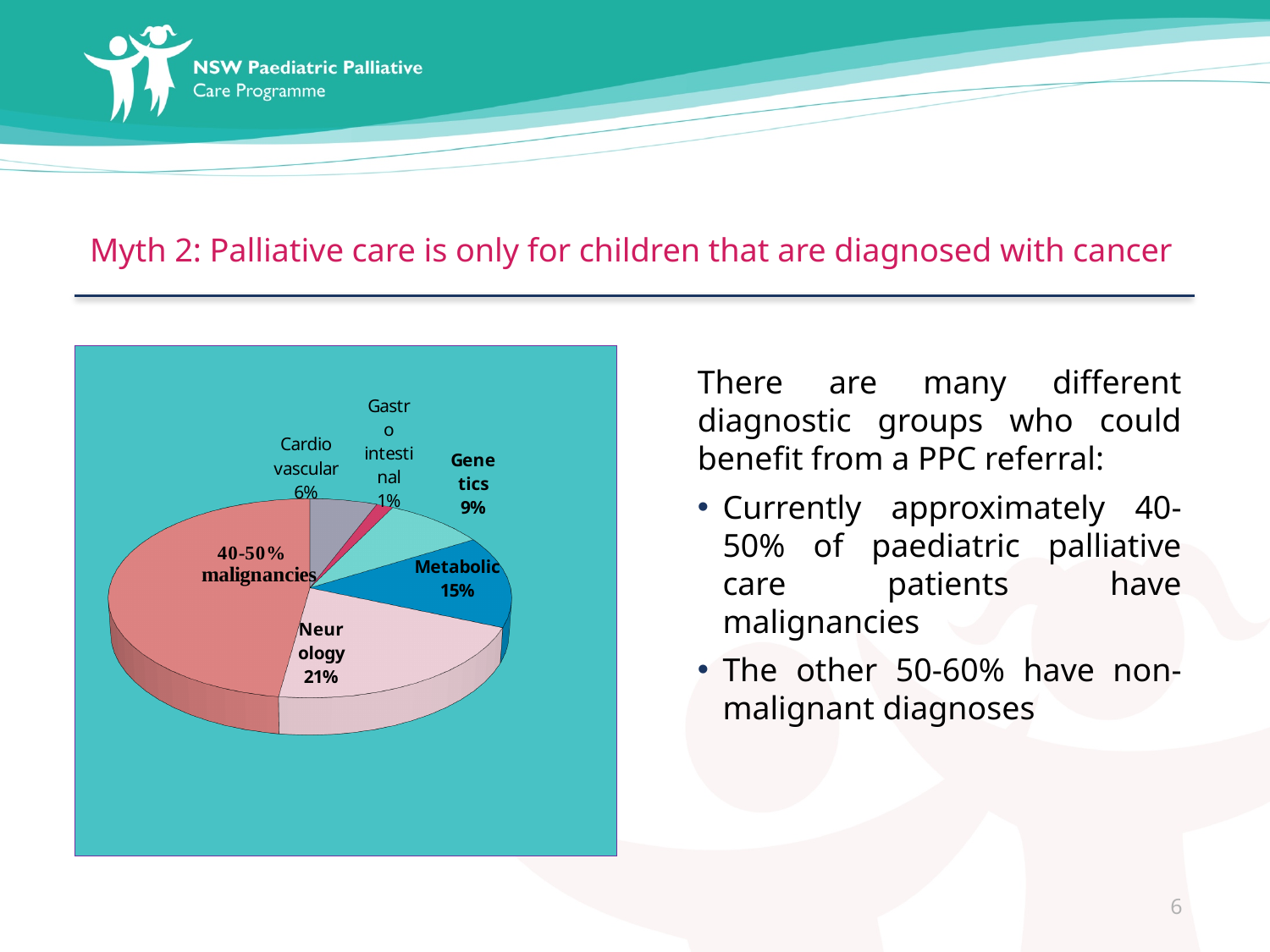
What is the difference in percentage points between the Neurology and Metabolic slices? 6 What percentage is shown for the Cardiovascular slice? 6% What percentage is shown for the Metabolic slice? 15% What percentage is shown for the Genetics slice? 9% How many slices does the pie chart have? 6 What percentage is shown for the Neurology slice? 21% What kind of chart is shown on the slide? pie chart What percentage is shown for the Gastrointestinal slice? 1% Which is larger, the Neurology slice or the Metabolic slice? Neurology What is the difference in percentage points between the Cardiovascular and Gastrointestinal slices? 5 Which slice of the pie chart is the largest? 40-50% malignancies Which slice of the pie chart is the smallest? Gastrointestinal